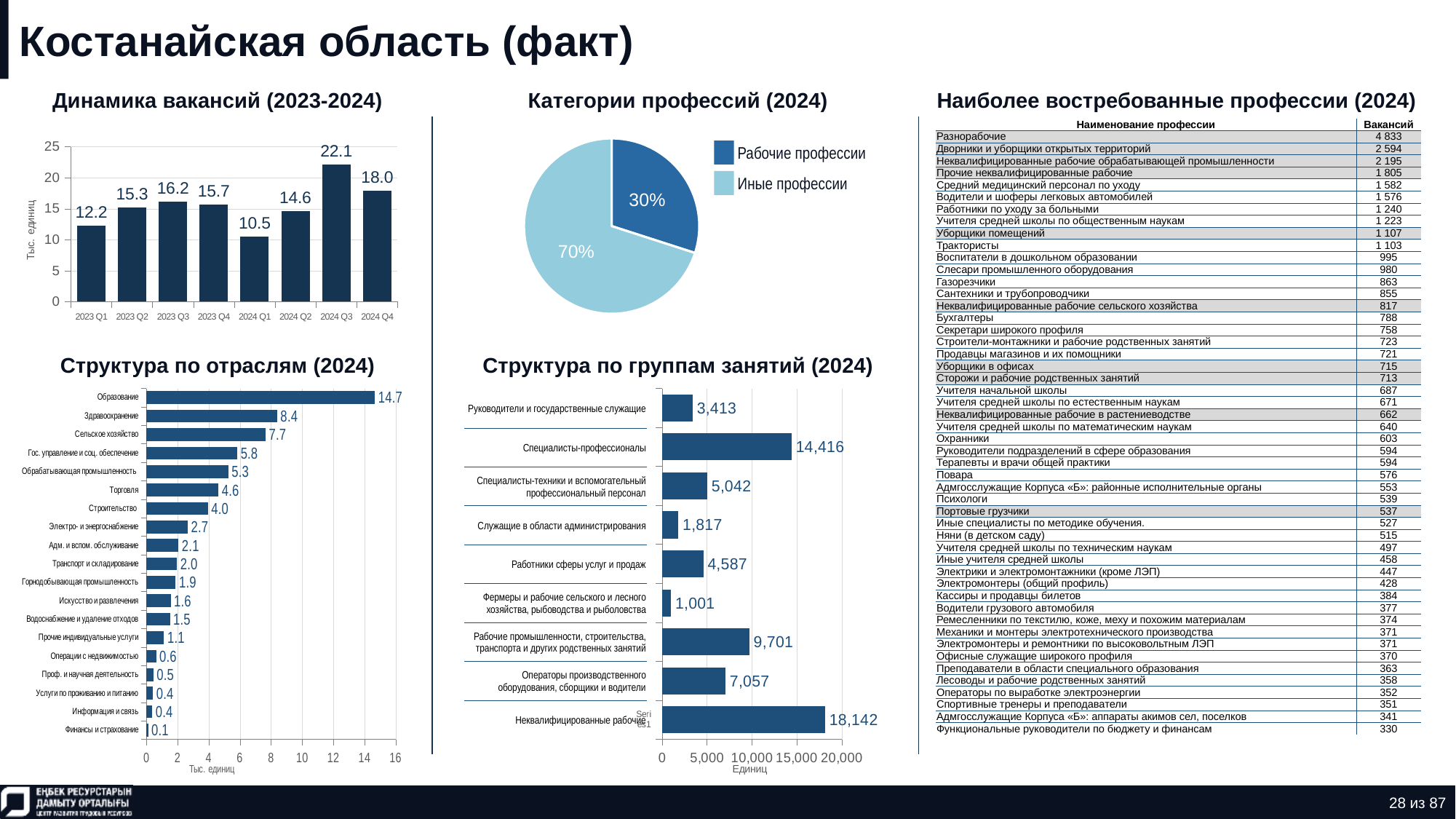
In the chart 'Динамика вакансий (2023-2024)', what is the value for 2024 Q3? 22.1 In the chart 'Структура по отраслям (2024)', which is larger: 'Торговля' or 'Строительство'? Торговля What kind of chart is 'Структура по группам занятий (2024)'? Bar chart In the chart 'Структура по отраслям (2024)', what is the value for 'Здравоохранение'? 8.4 In the chart 'Динамика вакансий (2023-2024)', how many quarters are plotted? 8 In the chart 'Структура по отраслям (2024)', which category has the highest value? Образование In the chart 'Структура по группам занятий (2024)', which category has the lowest value? Фермеры и рабочие сельского и лесного хозяйства, рыбоводства и рыболовства In the chart 'Структура по группам занятий (2024)', what is the value for 'Специалисты-профессионалы'? 14,416 In the chart 'Динамика вакансий (2023-2024)', which quarter has the lowest value? 2024 Q1 What kind of chart is 'Категории профессий (2024)'? Pie chart In the chart 'Категории профессий (2024)', what share of the pie is 'Рабочие профессии'? 30% In the chart 'Динамика вакансий (2023-2024)', what is the difference between the values for 2024 Q3 and 2024 Q4? 4.1